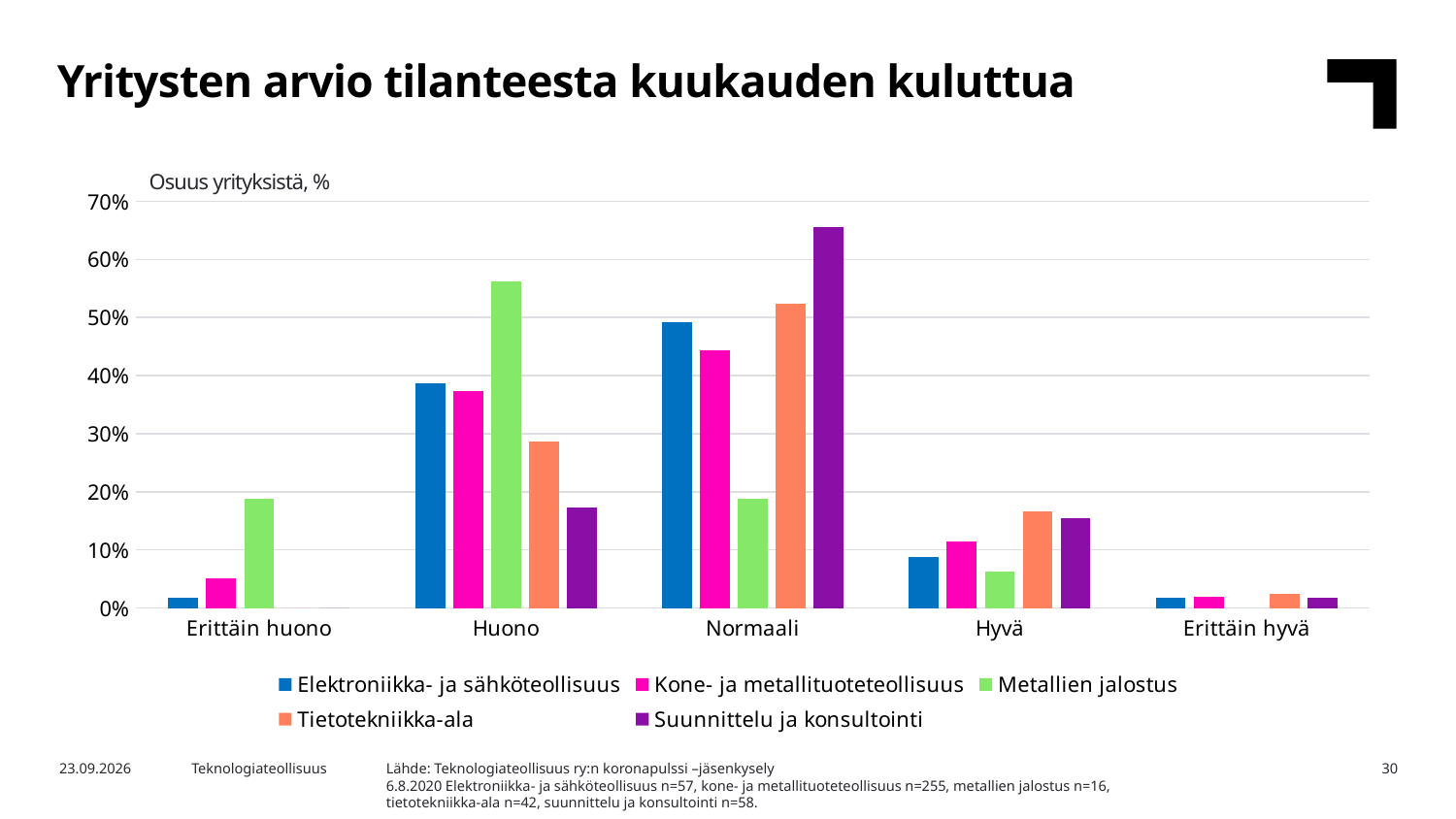
In the Erittäin huono category, which series has the highest value? Metallien jalostus In the Huono category, which is larger: Elektroniikka- ja sähköteollisuus or Tietotekniikka-ala? Elektroniikka- ja sähköteollisuus How many series does the chart legend list? 5 In the Normaali category, which series has the highest value? Suunnittelu ja konsultointi What is the label shown above the vertical axis of the chart? Osuus yrityksistä, % In the Hyvä category, which is larger: Tietotekniikka-ala or Metallien jalostus? Tietotekniikka-ala In the Huono category, which series has the highest value? Metallien jalostus What kind of chart is shown on the slide? bar chart Is the value for Suunnittelu ja konsultointi in the Normaali category greater or less than 60%? greater Is the value for Metallien jalostus in the Huono category greater or less than 50%? greater How many categories are shown on the x axis of the chart? 5 Is the value for Elektroniikka- ja sähköteollisuus in the Normaali category greater or less than 40%? greater